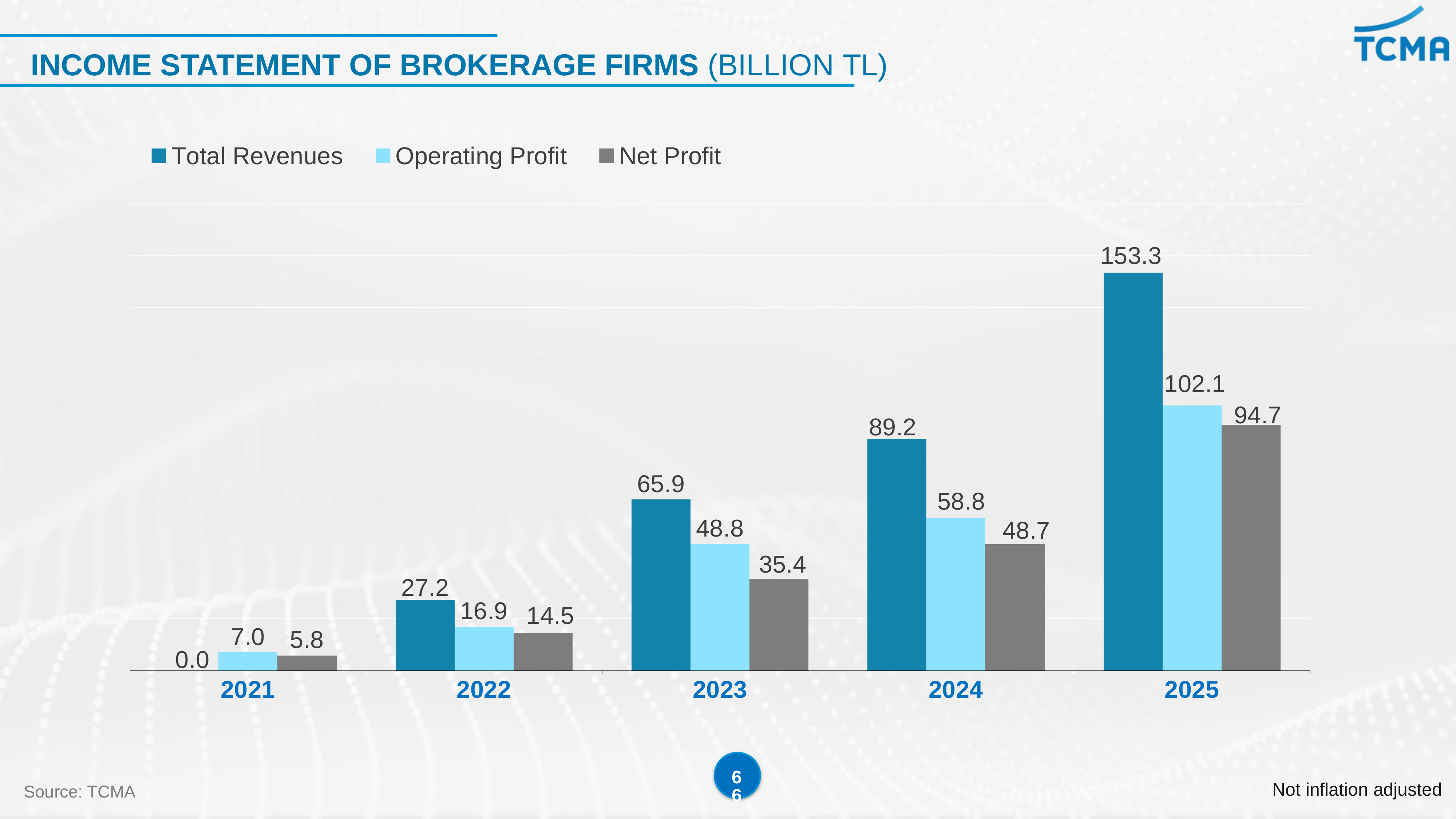
What is the Operating Profit value for 2023? 48.8 What kind of chart is shown on the slide? Bar chart What is the Net Profit value for 2022? 14.5 What is the difference between Operating Profit in 2024 and Operating Profit in 2023? 10.0 Which year has the highest Total Revenues? 2025 Which is larger: Operating Profit in 2022 or Net Profit in 2023? Net Profit in 2023 Which year has the lowest Net Profit? 2021 How many years are shown on the x axis? 5 What is the Total Revenues value for 2025? 153.3 How many series does the legend list? 3 What is the difference between Total Revenues and Net Profit in 2025? 58.6 What is the Net Profit value for 2024? 48.7